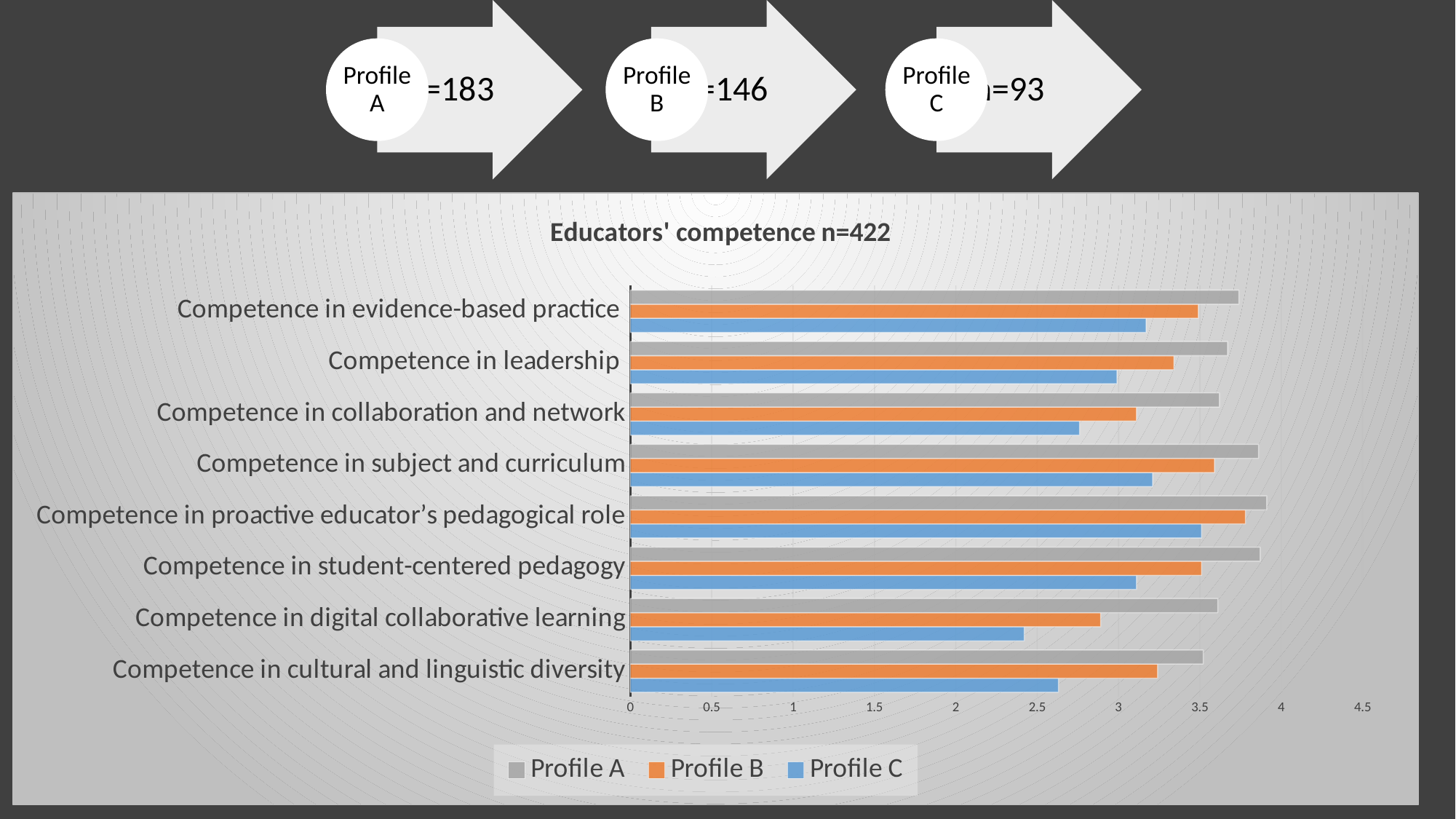
How many series does the chart legend list? 3 For Profile B, which competence category has the lowest value? Competence in digital collaborative learning Is the Profile A value for Competence in proactive educator's pedagogical role greater or less than 3.5? greater Is the Profile C value for Competence in digital collaborative learning greater or less than 2.5? less Which colour represents Profile B in the chart? Orange Is the Profile C value for Competence in collaboration and network greater or less than 3? less For Profile C, which competence category has the highest value? Competence in proactive educator's pedagogical role What is the title of the chart? Educators' competence n=422 What kind of chart is shown on the slide? Bar chart For Profile C, which competence category has the lowest value? Competence in digital collaborative learning How many competence categories are plotted on the chart? 8 For Competence in leadership, which is larger: the Profile B value or the Profile C value? Profile B